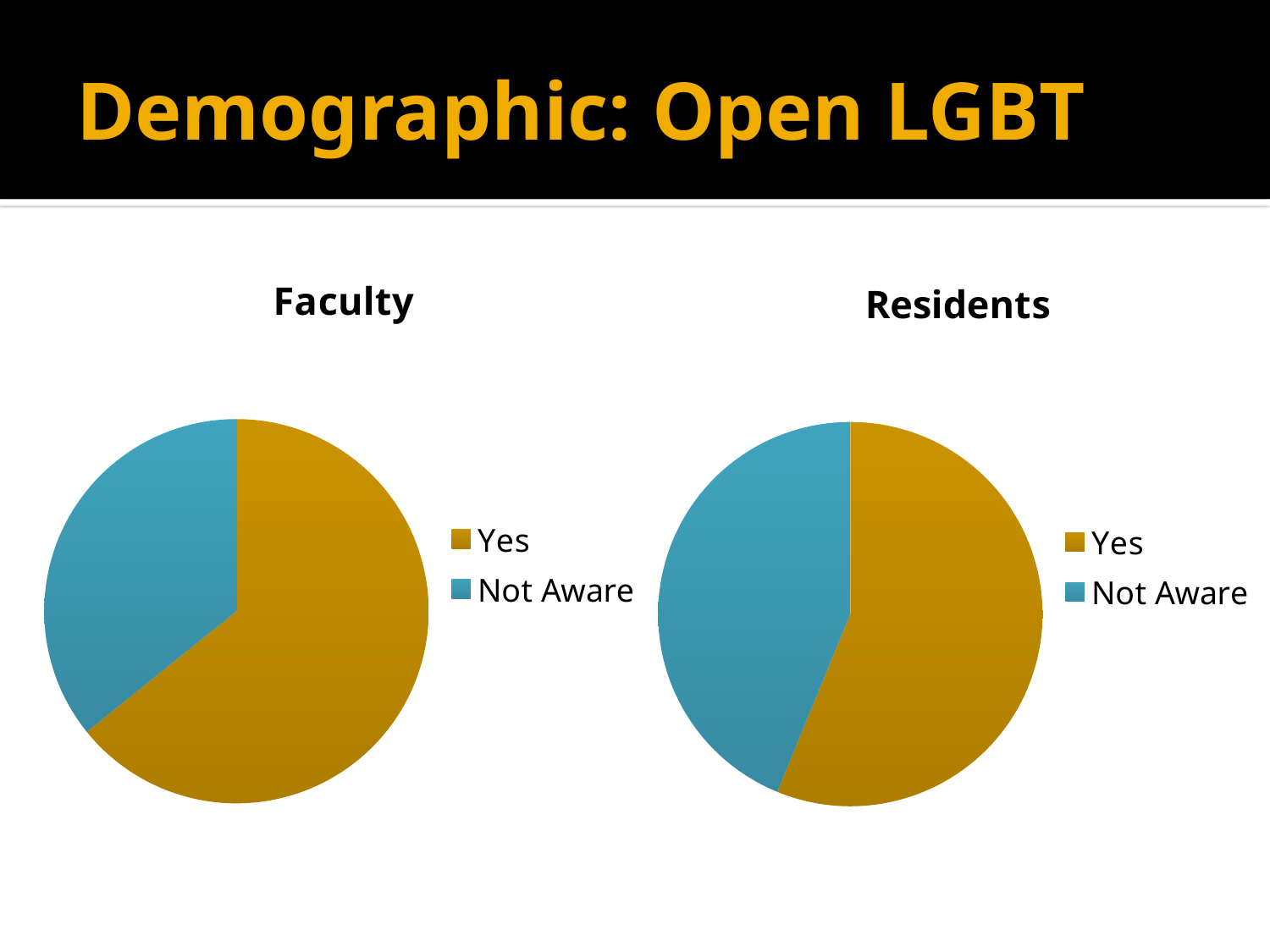
In the Residents chart, which slice is the largest? Yes In the Residents chart, which is larger: the Yes slice or the Not Aware slice? Yes How many entries does the legend of the Residents chart list? 2 In the Residents chart, which slice is the smallest? Not Aware How many slices does the Faculty pie chart have? 2 In the Faculty chart, which slice is the largest? Yes In the Faculty chart, which slice is the smallest? Not Aware In the Residents chart, what colour is the Not Aware slice? Blue What kind of chart is the Faculty chart? Pie chart What is the title of the chart on the left? Faculty In the Faculty chart, which is larger: the Yes slice or the Not Aware slice? Yes What kind of chart is the Residents chart? Pie chart